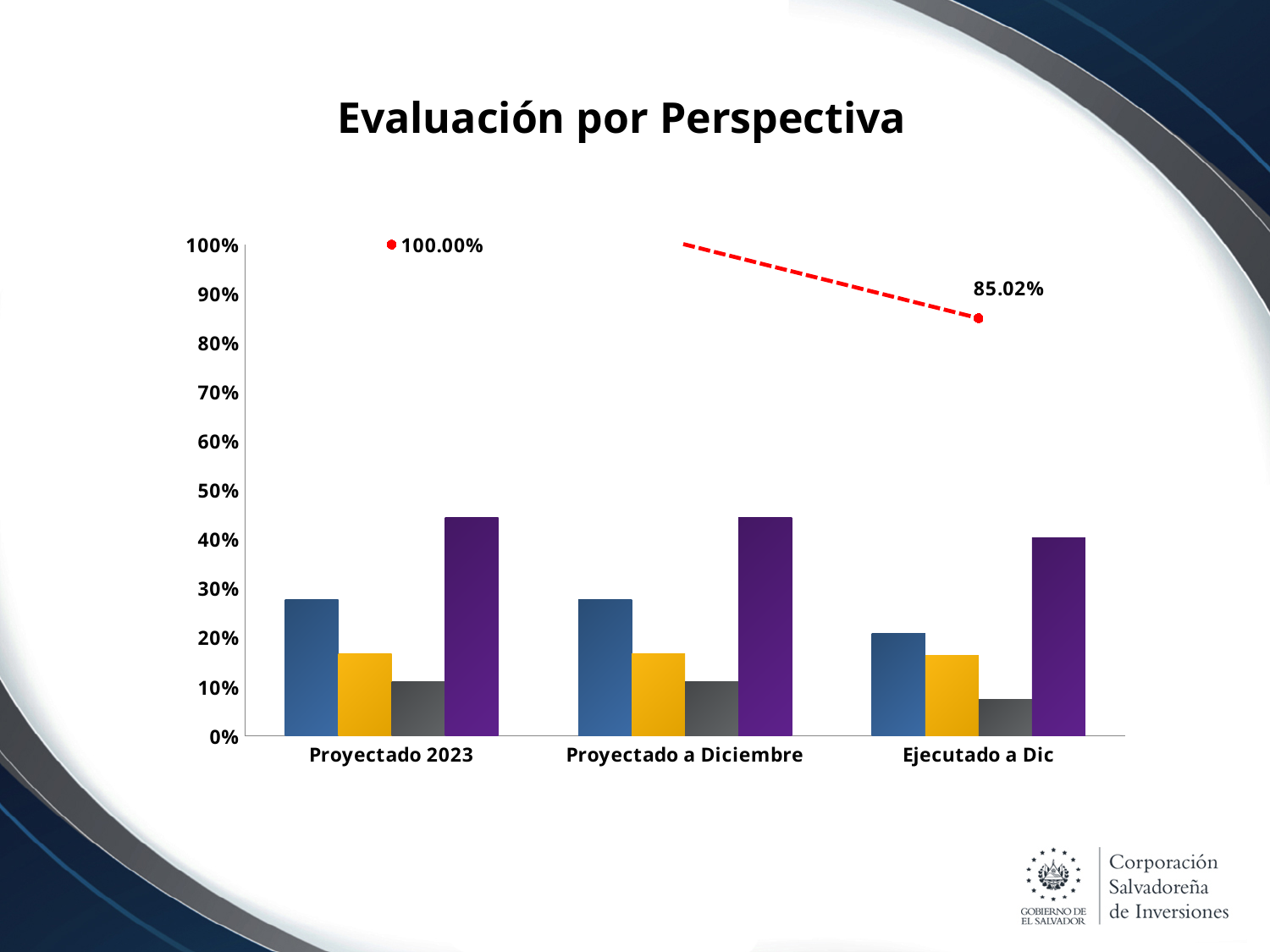
Is the purple bar for Proyectado 2023 greater or less than 40%? greater Is the gray bar for Ejecutado a Dic greater or less than 10%? less Does the red dashed line rise or fall from Proyectado 2023 to Ejecutado a Dic? fall Is the blue bar larger for Proyectado 2023 or for Ejecutado a Dic? Proyectado 2023 How many bars are shown for each category? 4 What value does the red dashed line show for Ejecutado a Dic? 85.02% What kind of chart is this? bar chart with a line What is the difference between the red line values for Proyectado 2023 and Ejecutado a Dic? 14.98% How many categories are shown on the x axis? 3 What is the title of the chart? Evaluación por Perspectiva Which bar is the tallest in the Proyectado 2023 group? the purple bar What value does the red dashed line show for Proyectado 2023? 100.00%